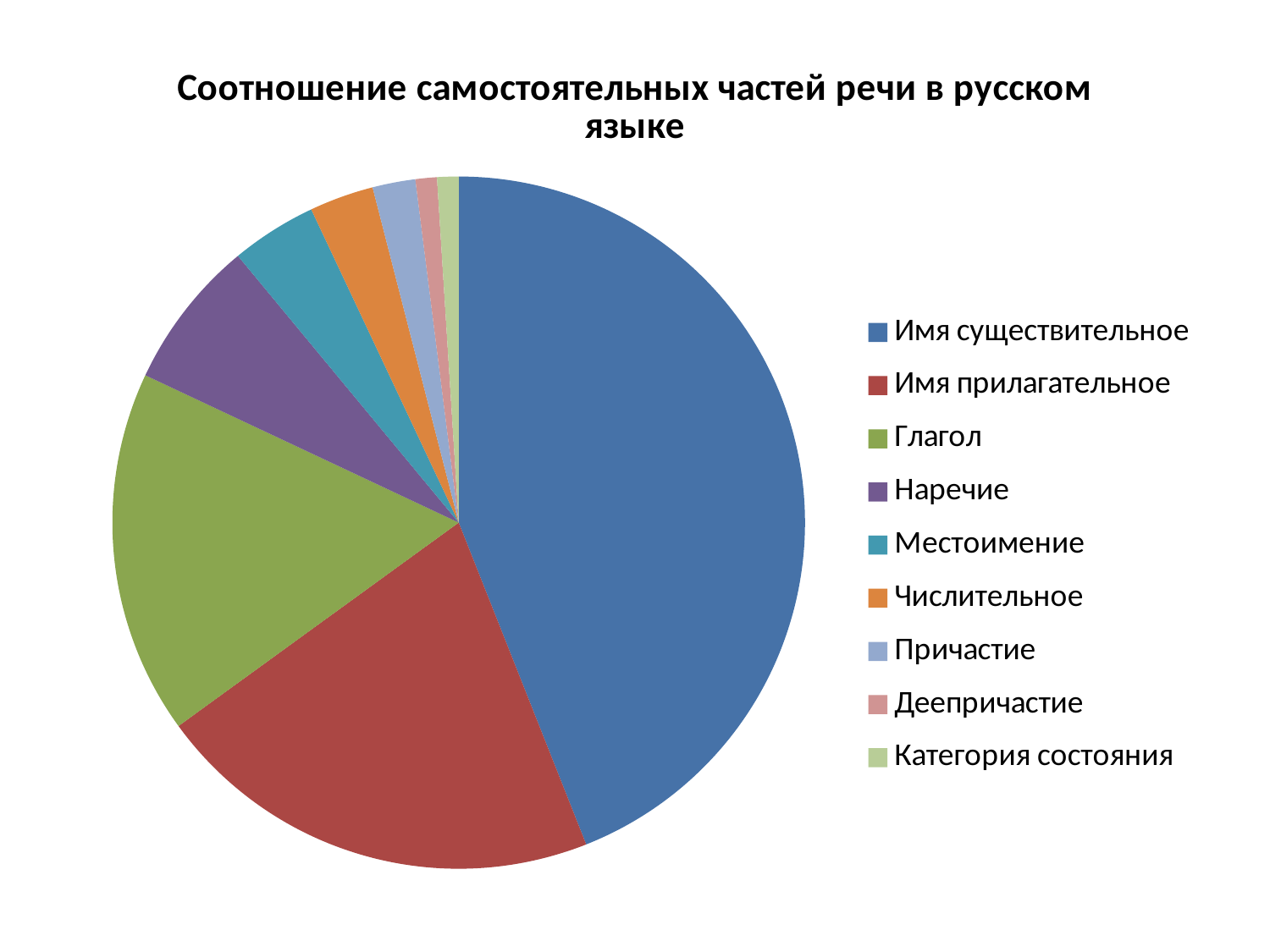
Which part of speech has the largest slice in the pie chart? Имя существительное Which slice is larger: Имя существительное or Имя прилагательное? Имя существительное How many categories (slices) does the pie chart have? 9 Which slice is larger: Местоимение or Причастие? Местоимение Which slice is larger: Числительное or Имя существительное? Имя существительное What is the title of the chart? Соотношение самостоятельных частей речи в русском языке What kind of chart is shown on the slide? pie chart What colour is the slice for Глагол? green